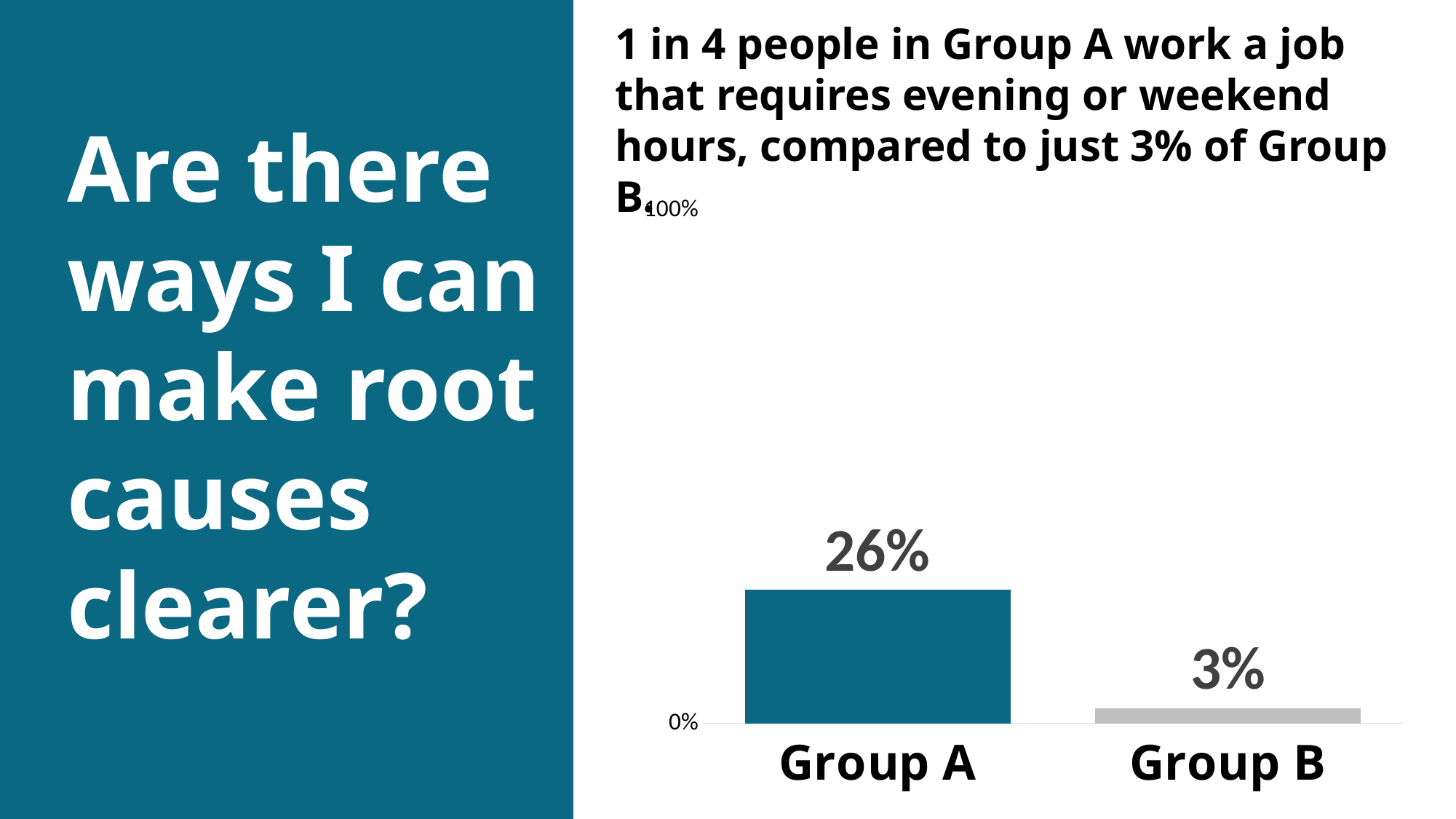
What is the top tick label on the vertical axis of the chart? 100% What colour is the bar for Group A? Teal What is the value for Group B? 3% How many categories are shown in the chart? 2 Which group has the highest value? Group A What kind of chart is shown on the slide? Bar chart Which group has the lowest value? Group B Which is larger, the value for Group A or Group B? Group A What is the value for Group A? 26% What is the difference between the values for Group A and Group B? 23%